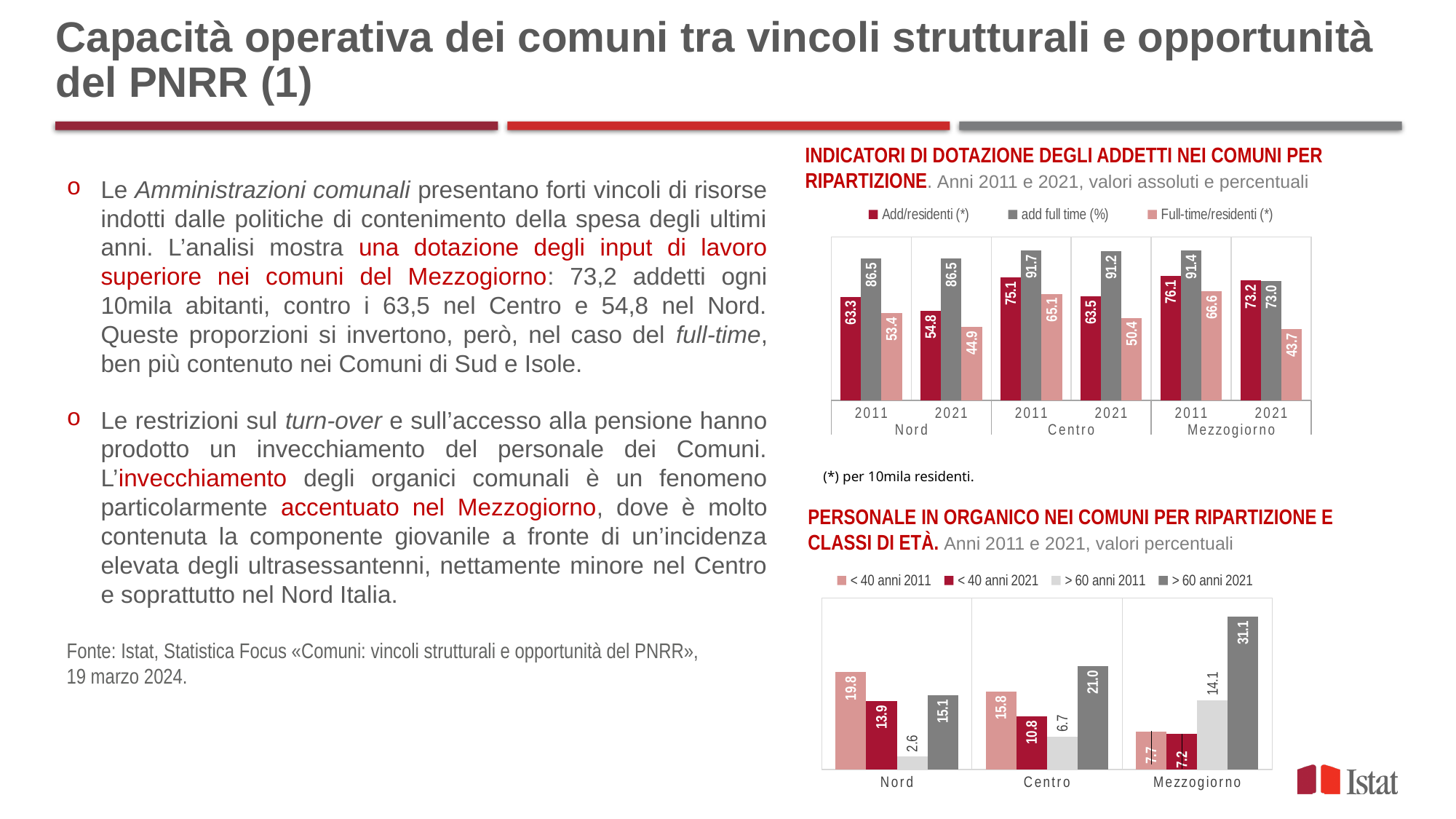
What type of chart is the bottom chart (Personale in organico per classi di età)? bar chart In the bottom chart (Personale in organico per classi di età), how many regions are shown on the x axis? 3 In the top chart (Indicatori di dotazione degli addetti), is the Full-time/residenti value for Mezzogiorno in 2021 larger or smaller than for Centro in 2021? smaller In the bottom chart (Personale in organico per classi di età), how many series does the legend list? 4 In the bottom chart (Personale in organico per classi di età), what is the > 60 anni 2021 value for Mezzogiorno? 31.1 In the top chart (Indicatori di dotazione degli addetti), which region-year group has the highest add full time (%) value? Centro 2011 In the bottom chart (Personale in organico per classi di età), what is the difference between the < 40 anni 2011 and < 40 anni 2021 values for Nord? 5.9 In the bottom chart (Personale in organico per classi di età), which region has the lowest > 60 anni 2011 value? Nord In the top chart (Indicatori di dotazione degli addetti), how many series does the legend list? 3 In the top chart (Indicatori di dotazione degli addetti), what is the Full-time/residenti value for Nord in 2021? 44.9 In the top chart (Indicatori di dotazione degli addetti), what is the difference between the Add/residenti values for Nord in 2011 and Nord in 2021? 8.5 In the top chart (Indicatori di dotazione degli addetti), what is the Add/residenti value for Mezzogiorno in 2021? 73.2